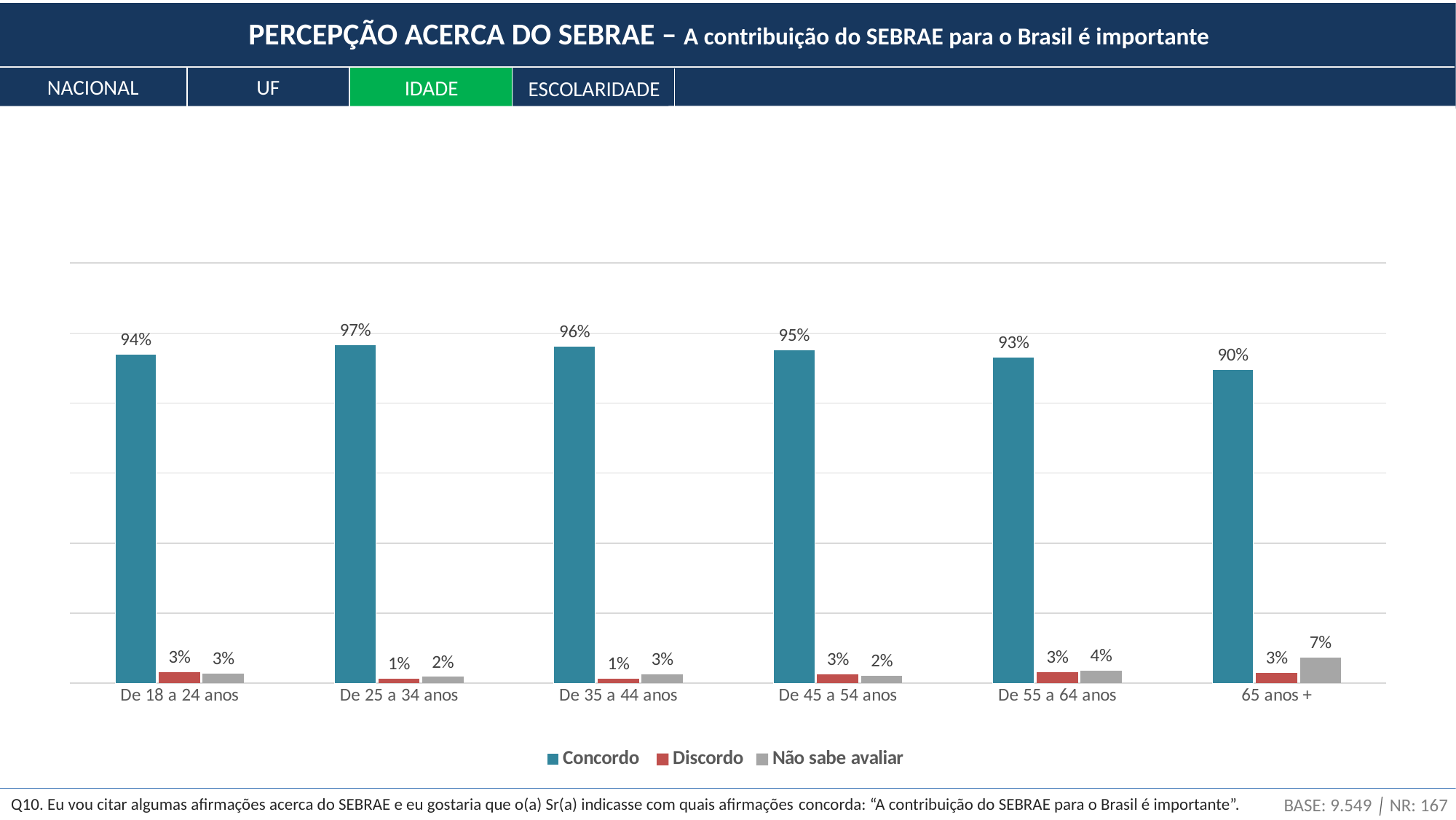
Do the Concordo values rise or fall from De 35 a 44 anos to 65 anos +? fall What is the Discordo value for De 45 a 54 anos? 3% What is the Não sabe avaliar value for 65 anos +? 7% Which tab is highlighted in green on the slide? IDADE Which age group has the lowest Concordo value? 65 anos + How many age groups are shown on the x axis? 6 Which age group has the highest Concordo value? De 25 a 34 anos What is the difference between the Concordo values for De 25 a 34 anos and 65 anos +? 7% How many series does the legend list? 3 Which is larger, the Concordo value for De 18 a 24 anos or for De 55 a 64 anos? De 18 a 24 anos What kind of chart is shown on the slide? bar chart What is the Concordo value for De 25 a 34 anos? 97%